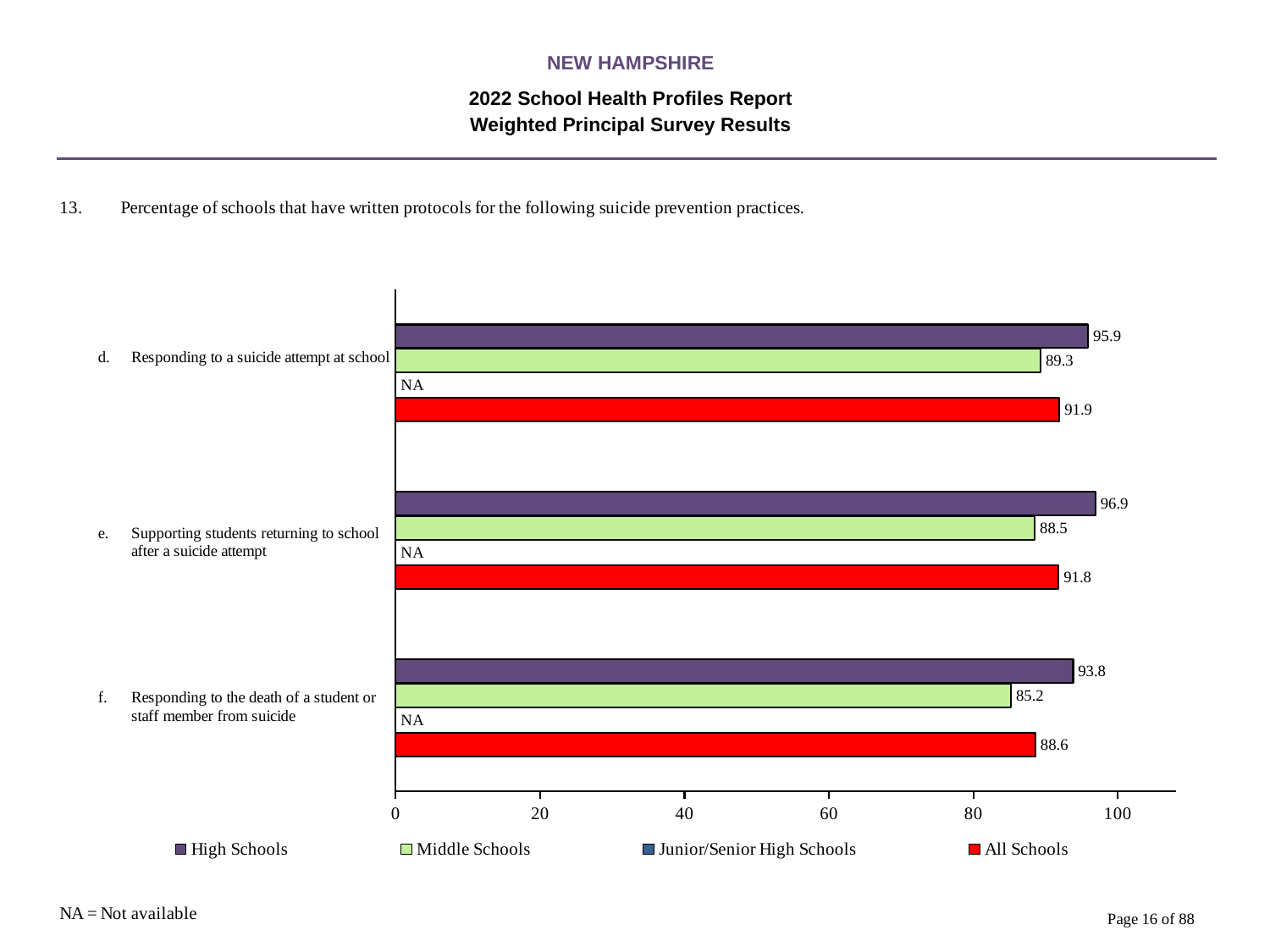
What is the difference between the High Schools and Middle Schools values for 'Responding to the death of a student or staff member from suicide'? 8.6 Which category has the highest High Schools value? Supporting students returning to school after a suicide attempt What is the High Schools value for 'Responding to a suicide attempt at school'? 95.9 What is the All Schools value for 'Responding to the death of a student or staff member from suicide'? 88.6 Is the Middle Schools value for 'Responding to the death of a student or staff member from suicide' greater or less than 80? greater How many series does the legend list? 4 Which category has the lowest Middle Schools value? Responding to the death of a student or staff member from suicide What is shown for Junior/Senior High Schools for 'Responding to a suicide attempt at school'? NA What is the Middle Schools value for 'Supporting students returning to school after a suicide attempt'? 88.5 Which is larger for 'Responding to a suicide attempt at school': the Middle Schools value or the All Schools value? All Schools What kind of chart is shown on the slide? bar chart How many categories are shown on the chart? 3